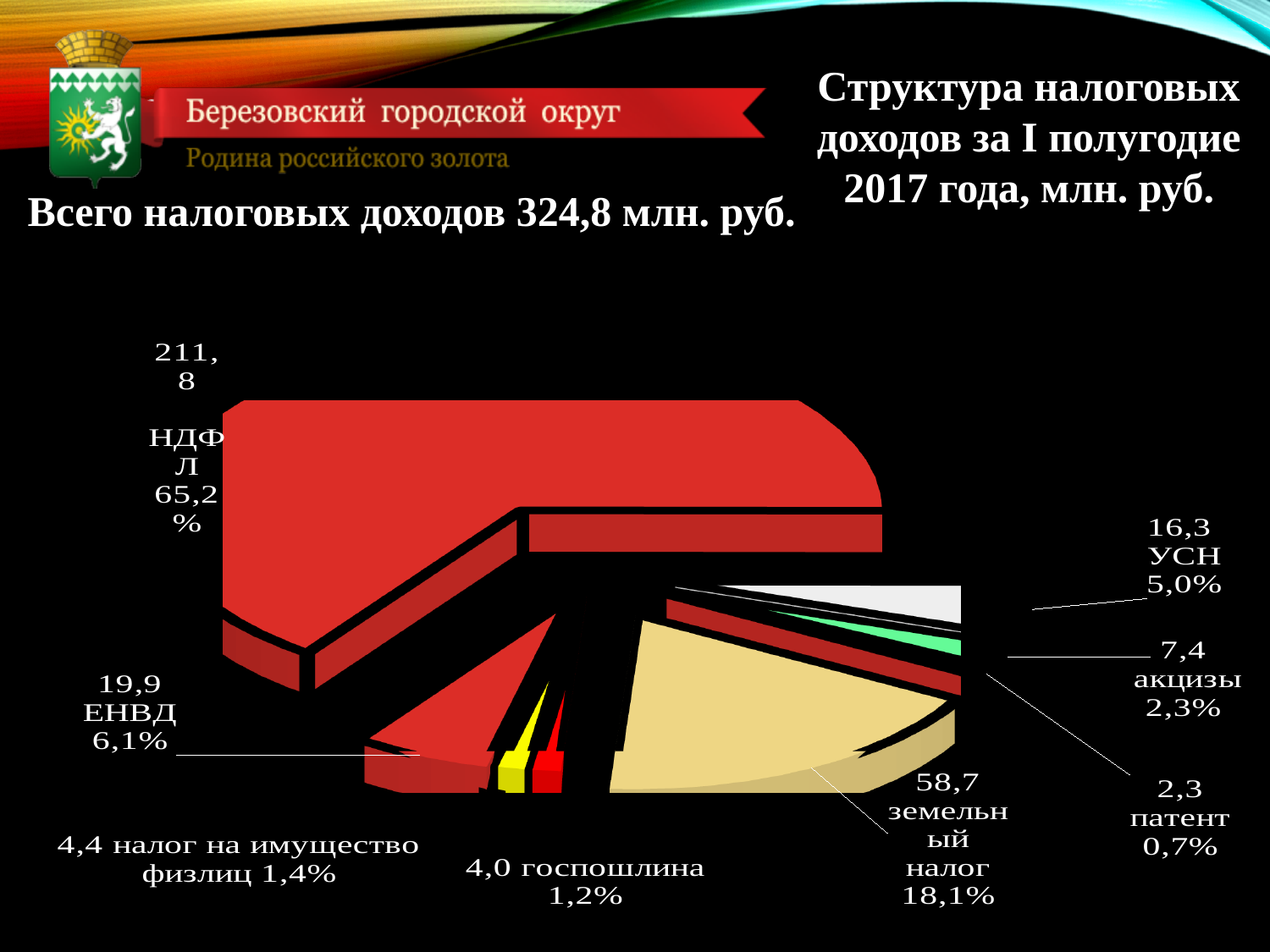
What is the value for ЕНВД? 19,9 Which category has the smallest slice of the pie? патент Which category has the largest slice of the pie? НДФЛ What is the value for госпошлина? 4,0 How many slices does the pie chart have? 8 What is the value for НДФЛ in the pie chart? 211,8 What share of the pie does земельный налог represent? 18,1% What kind of chart is shown on the slide? pie chart What is the title of the chart? Структура налоговых доходов за I полугодие 2017 года, млн. руб. What share of the pie does УСН represent? 5,0% What is the difference between the values for земельный налог and ЕНВД? 38,8 Which is larger, the value for акцизы or the value for УСН? УСН